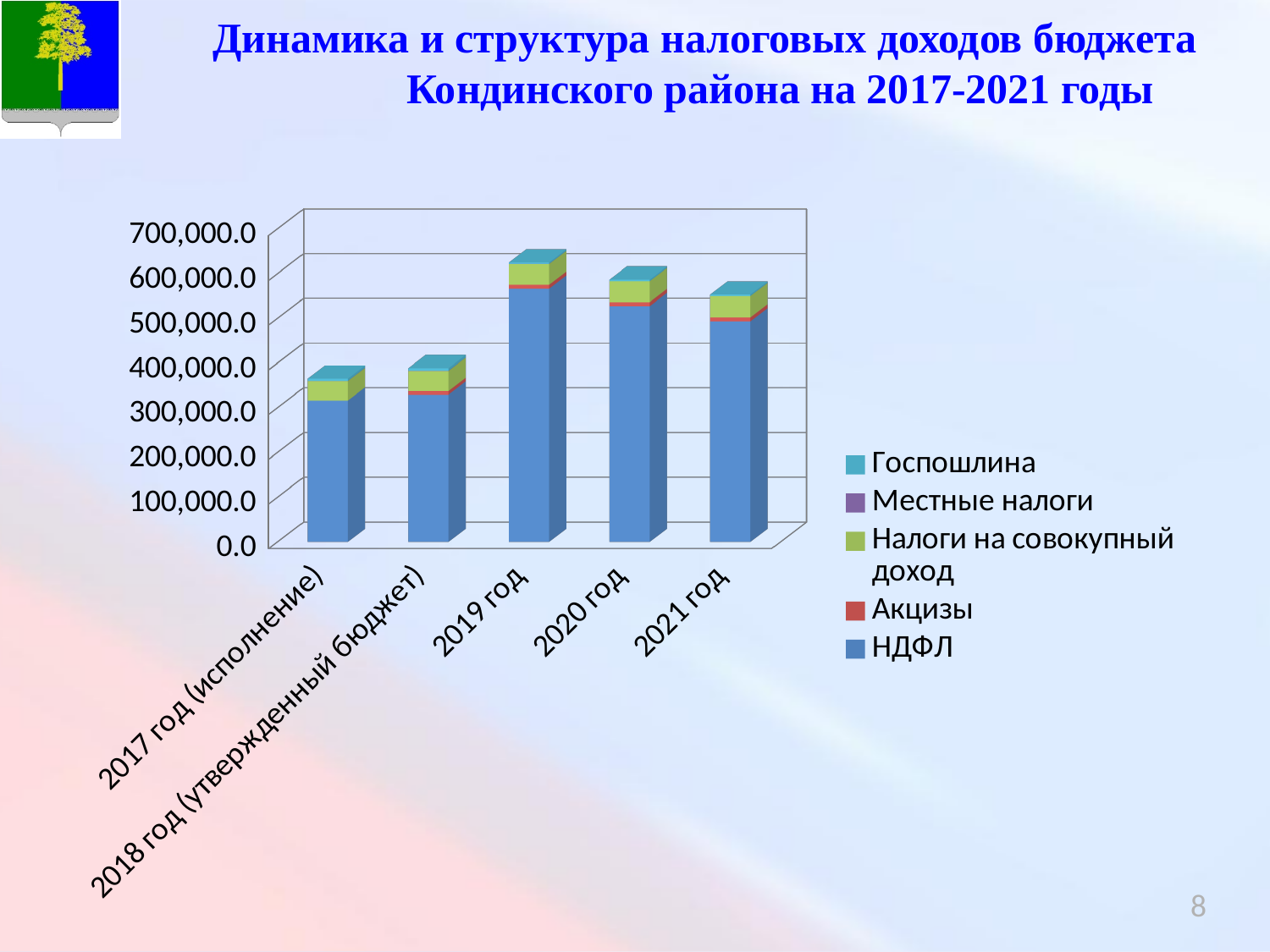
How many categories (bars) are shown on the x axis? 5 Which series forms the bottom (largest) segment of each stacked bar? НДФЛ Is the total for 2020 год greater or less than 700,000.0? less Is the total for 2017 год (исполнение) greater or less than 400,000.0? less What kind of chart is shown on the slide? Stacked bar chart Which stacked bar is taller: 2018 год (утвержденный бюджет) or 2019 год? 2019 год Is the total for 2019 год greater or less than 500,000.0? greater How many series does the legend list? 5 Which category has the shortest stacked bar? 2017 год (исполнение) Which series is shown in red in the legend? Акцизы Which category has the tallest stacked bar? 2019 год